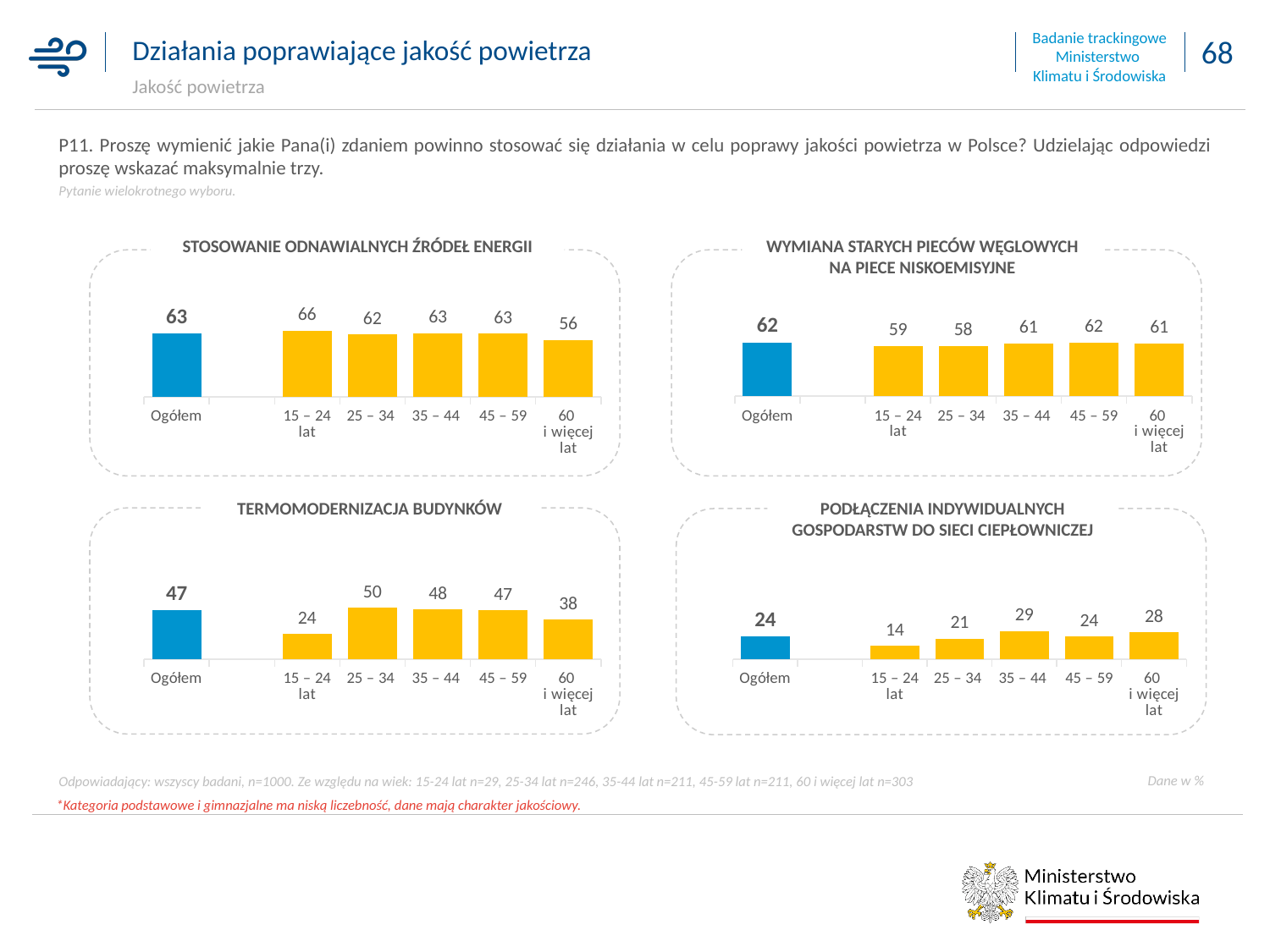
How many bars are shown in the chart titled 'TERMOMODERNIZACJA BUDYNKÓW'? 6 What type of chart is used in the chart titled 'STOSOWANIE ODNAWIALNYCH ŹRÓDEŁ ENERGII'? Bar chart In the chart titled 'PODŁĄCZENIA INDYWIDUALNYCH GOSPODARSTW DO SIECI CIEPŁOWNICZEJ', what is the value for Ogółem? 24 In the chart titled 'TERMOMODERNIZACJA BUDYNKÓW', which age group has the highest value? 25 – 34 In the chart titled 'TERMOMODERNIZACJA BUDYNKÓW', what is the difference between the values for 25 – 34 and 15 – 24? 26 In the chart titled 'TERMOMODERNIZACJA BUDYNKÓW', what is the value for the 15 – 24 age group? 24 In the chart titled 'STOSOWANIE ODNAWIALNYCH ŹRÓDEŁ ENERGII', which age group has the lowest value? 60 i więcej lat In the chart titled 'WYMIANA STARYCH PIECÓW WĘGLOWYCH NA PIECE NISKOEMISYJNE', what is the value for the 25 – 34 age group? 58 In the chart titled 'PODŁĄCZENIA INDYWIDUALNYCH GOSPODARSTW DO SIECI CIEPŁOWNICZEJ', which is larger: the value for 60 i więcej lat or the value for 45 – 59? 60 i więcej lat In the chart titled 'WYMIANA STARYCH PIECÓW WĘGLOWYCH NA PIECE NISKOEMISYJNE', what is the difference between the values for 45 – 59 and 25 – 34? 4 In the chart titled 'STOSOWANIE ODNAWIALNYCH ŹRÓDEŁ ENERGII', what is the value for Ogółem? 63 In the chart titled 'PODŁĄCZENIA INDYWIDUALNYCH GOSPODARSTW DO SIECI CIEPŁOWNICZEJ', which age group has the highest value? 35 – 44